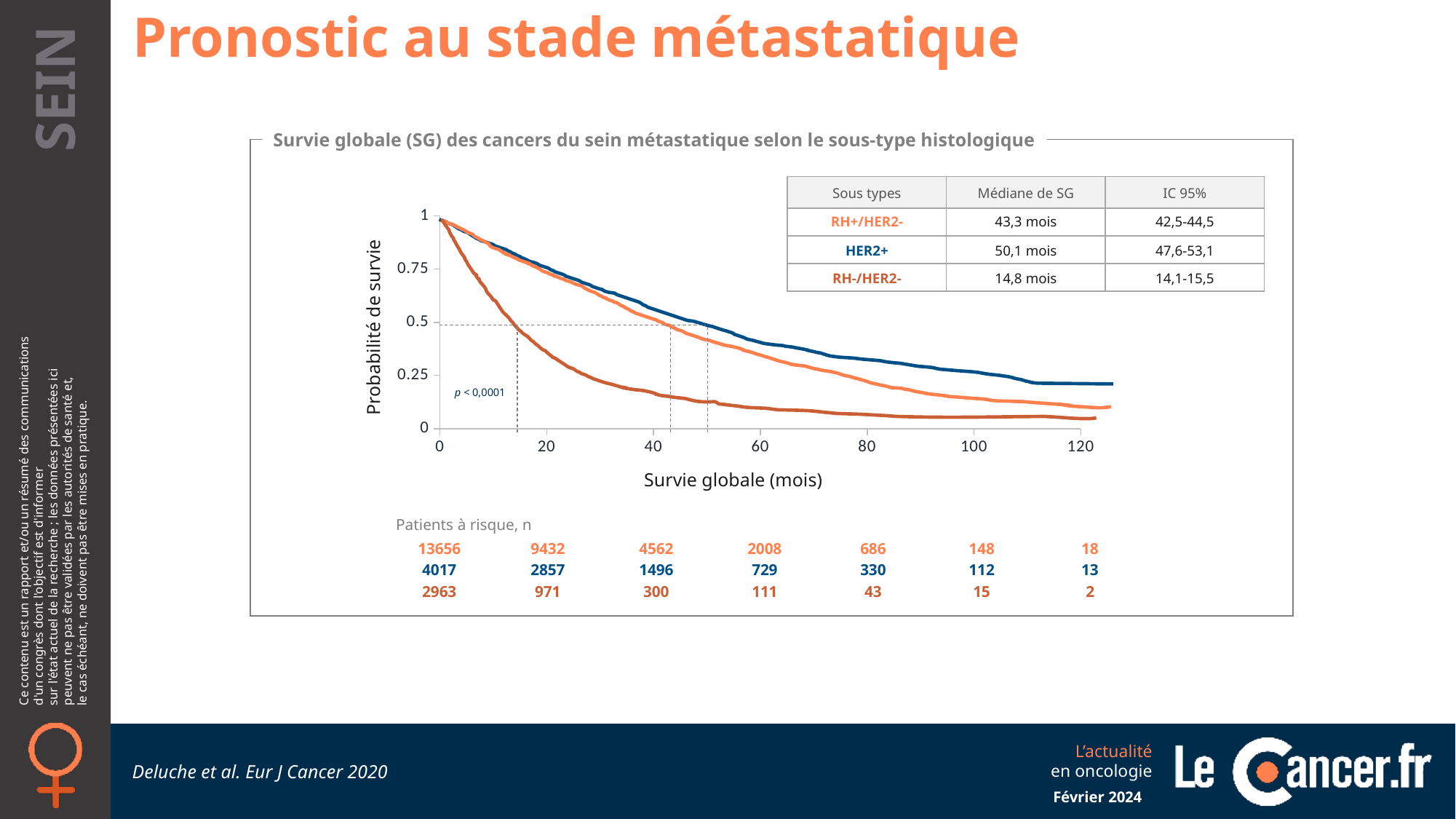
Is the survival probability for RH-/HER2- at 20 months greater or less than 0.5? less Do the survival curves rise or fall as overall survival time increases along the x axis? fall How many RH+/HER2- patients are at risk at 0 months? 13656 What is the median overall survival for the RH-/HER2- subtype? 14,8 mois Which subtype has the lowest median overall survival? RH-/HER2- What is the median overall survival (Médiane de SG) for the HER2+ subtype? 50,1 mois How many subtypes (series) are plotted on the survival chart? 3 What kind of chart is shown on the slide? line chart Which subtype has the highest median overall survival? HER2+ What is the difference in median overall survival between HER2+ and RH+/HER2-? 6,8 mois What is the 95% confidence interval (IC 95%) for the median survival of RH+/HER2-? 42,5-44,5 How many HER2+ patients are at risk at 40 months? 1496